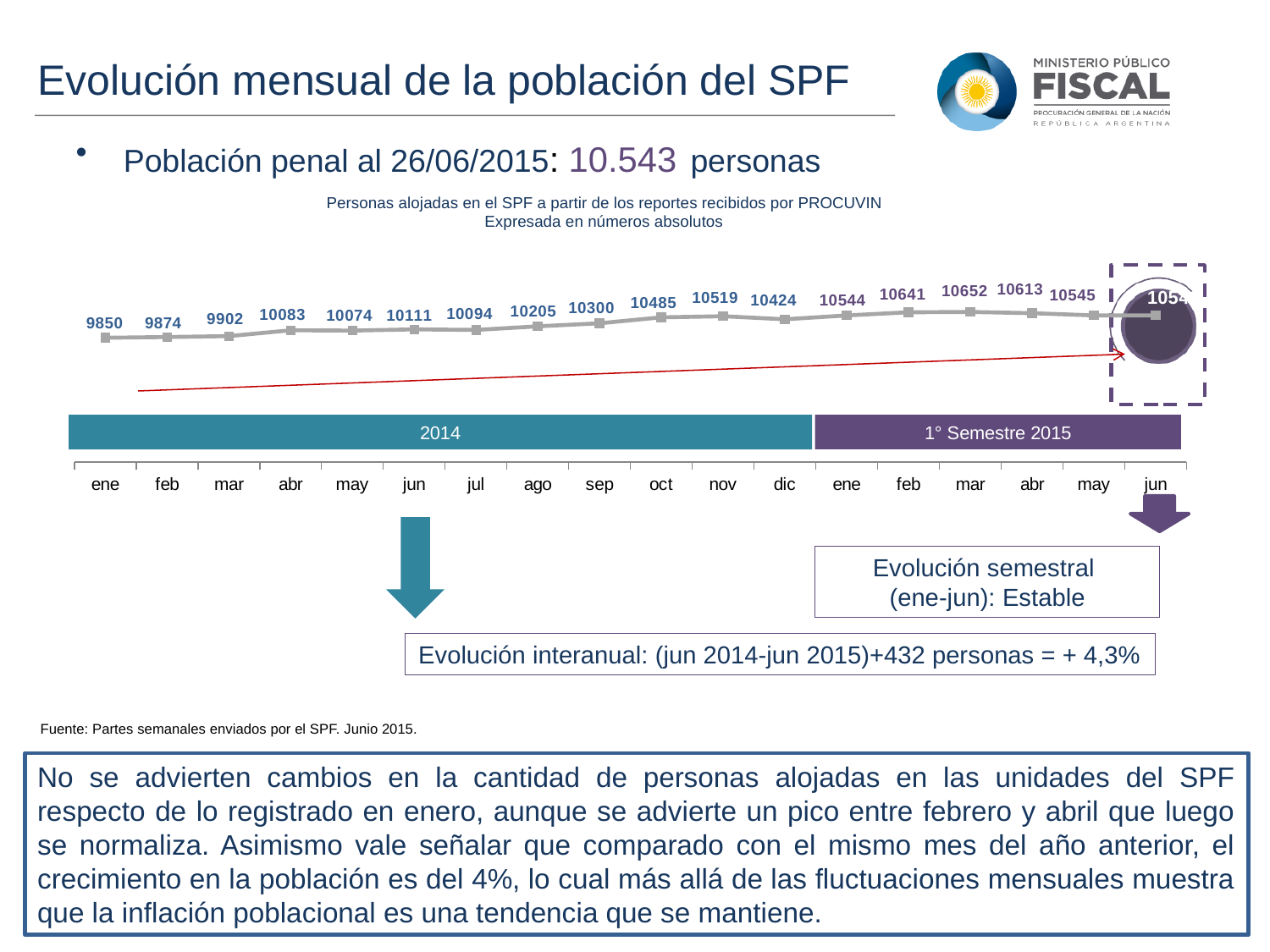
What is the value for dic 2014? 10424 Which is larger, the value for abr 2014 or the value for may 2014? abr 2014 What is the value for mar 2015? 10652 Which month has the highest value on the chart? mar 2015 What kind of chart is shown on the slide? line chart What is the value for sep 2014? 10300 What is the difference between the values for nov 2014 and dic 2014? 95 Which month has the lowest value on the chart? ene 2014 How many monthly data points are plotted on the chart? 18 What is the difference between the values for ene 2015 and ene 2014? 694 What is the value for ene 2014? 9850 Do the values generally rise or fall from ene 2014 to dic 2014? rise